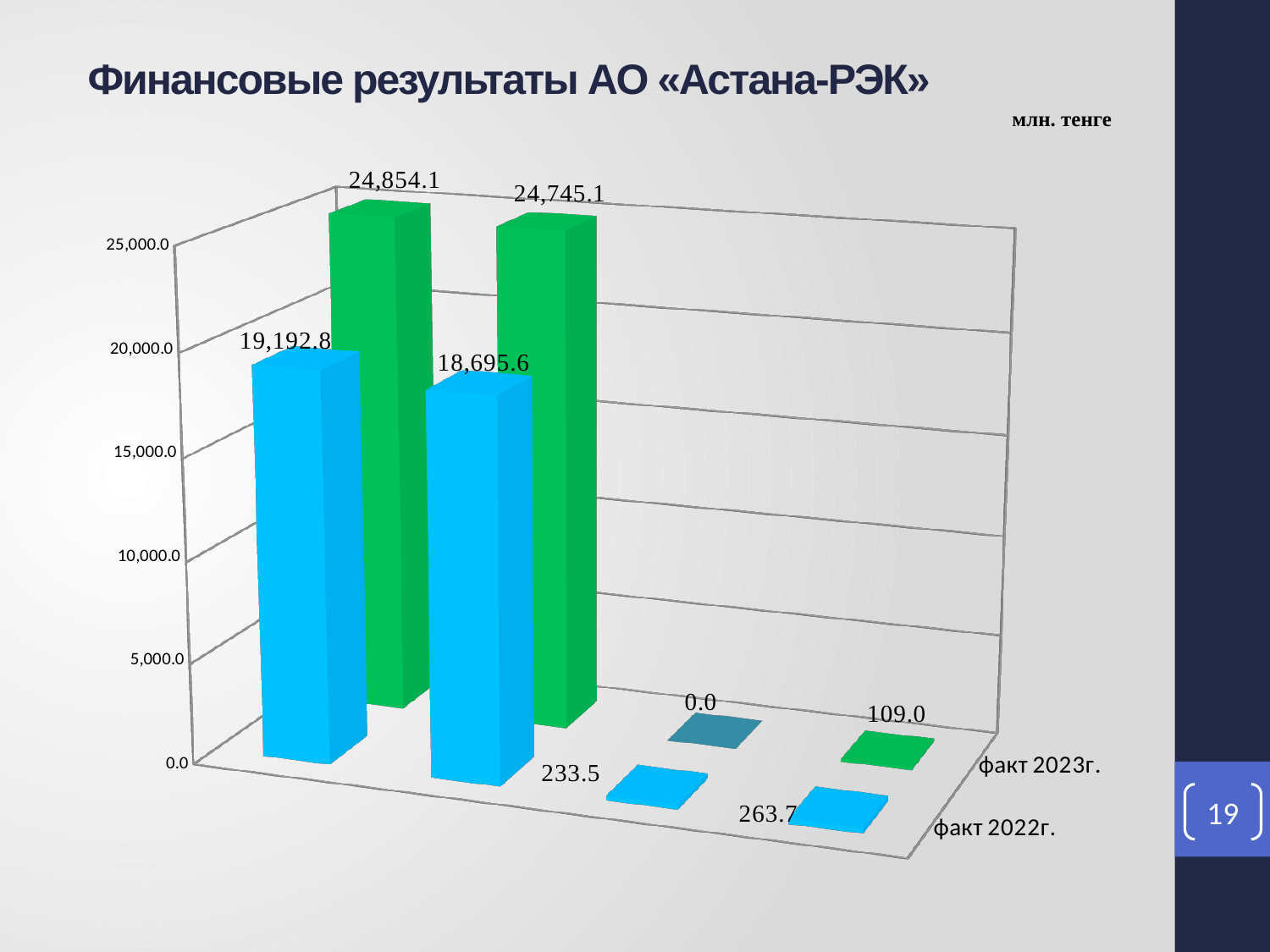
What is the difference between the tallest bar of факт 2023г. (24,854.1) and the tallest bar of факт 2022г. (19,192.8)? 5,661.3 What type of chart is shown on the slide? bar chart What is the lowest value in the series факт 2022г.? 233.5 For the second category from the left, which series has the larger value: факт 2022г. or факт 2023г.? факт 2023г. What is the highest value in the series факт 2023г.? 24,854.1 How many data series does the chart show? 2 What is the lowest value in the series факт 2023г.? 0.0 How many bars are plotted for the series факт 2023г.? 4 Is the tallest bar of the series факт 2022г. greater or less than 20,000.0? less What is the title of the chart? Финансовые результаты АО «Астана-РЭК» In what units are the chart values given, according to the label above the chart? млн. тенге What is the highest value in the series факт 2022г.? 19,192.8